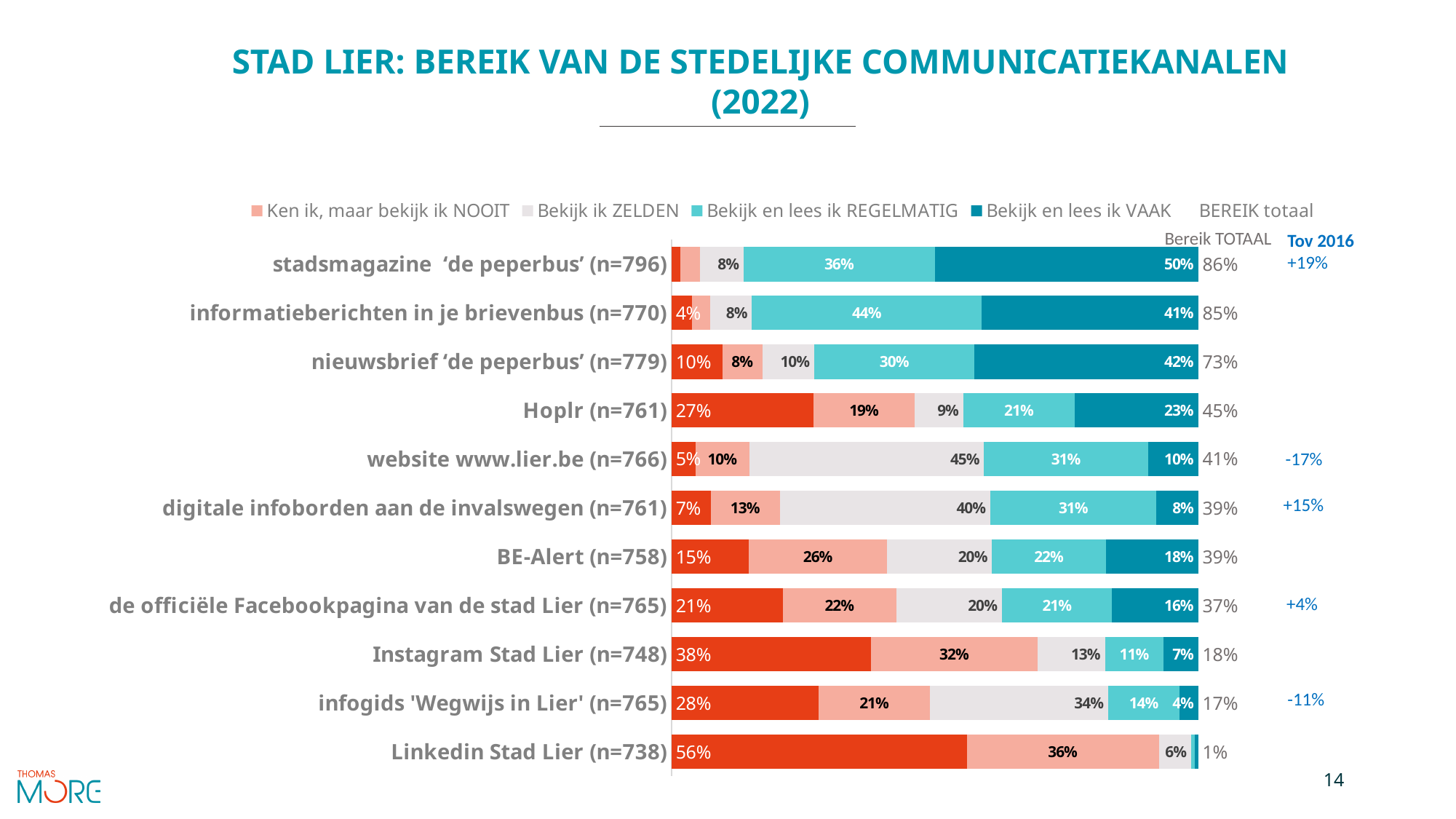
Which has a larger 'Bekijk en lees ik REGELMATIG' share: informatieberichten in je brievenbus or stadsmagazine 'de peperbus'? informatieberichten in je brievenbus How many communication channels (categories) are plotted in the chart? 11 What is the difference in 'Bereik TOTAAL' between stadsmagazine 'de peperbus' and nieuwsbrief 'de peperbus'? 13 percentage points What is the 'Bekijk en lees ik VAAK' value for stadsmagazine 'de peperbus' (n=796)? 50% Which channel has the lowest 'Bereik TOTAAL'? Linkedin Stad Lier (n=738) What is the 'Tov 2016' value shown for website www.lier.be? -17% Which channel has the highest 'Bereik TOTAAL'? stadsmagazine 'de peperbus' (n=796) What is the 'Bekijk ik ZELDEN' value for website www.lier.be (n=766)? 45% How many entries does the chart legend list? 5 What is the 'Bereik TOTAAL' value for Hoplr (n=761)? 45% What kind of chart is shown on the slide? Stacked bar chart What is the 'Ken ik, maar bekijk ik NOOIT' value for Instagram Stad Lier (n=748)? 32%